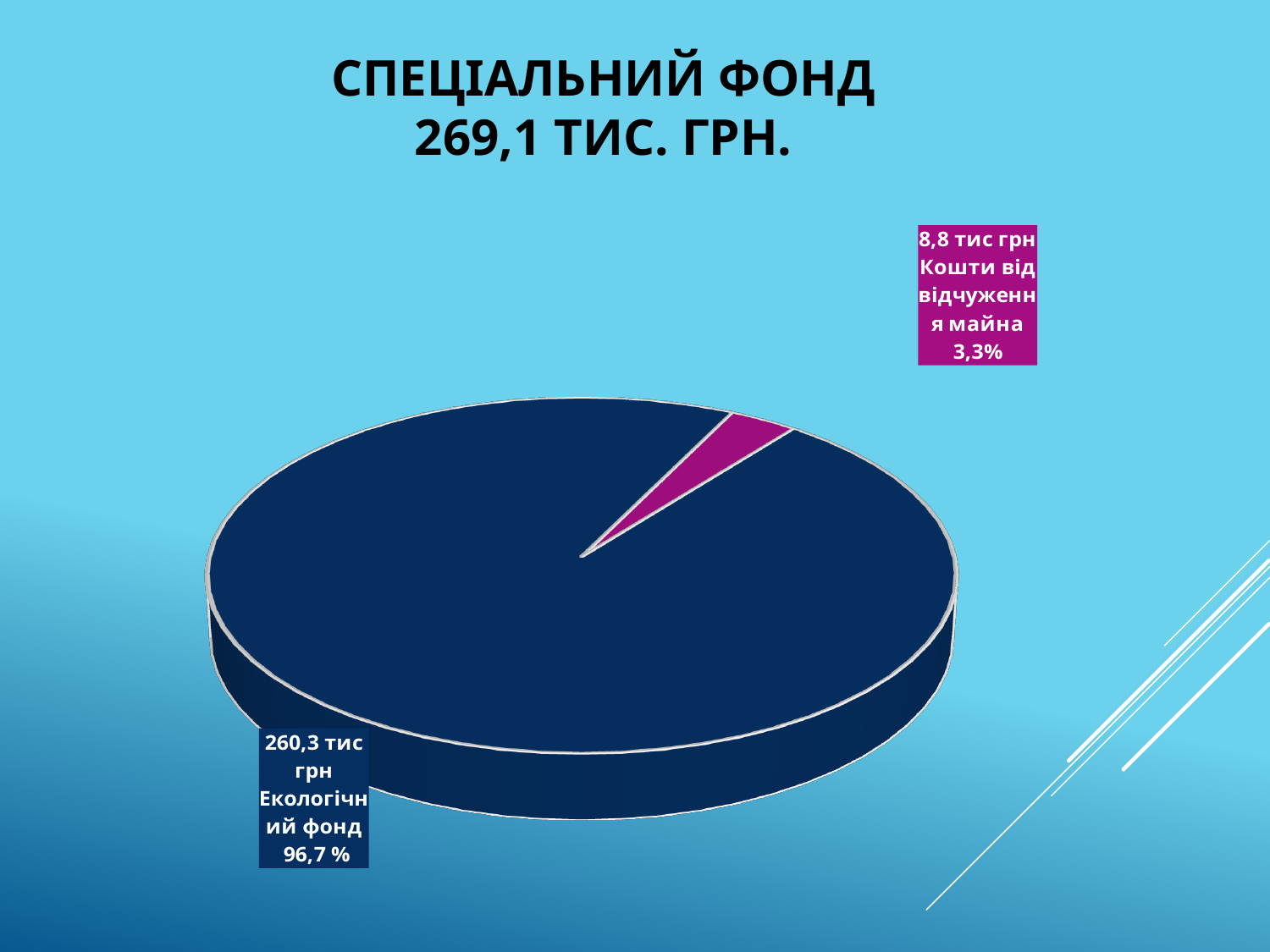
Which is larger, Екологічний фонд or Кошти від відчуження майна? Екологічний фонд What kind of chart is shown on the slide? pie chart What is the title of the chart? СПЕЦІАЛЬНИЙ ФОНД 269,1 ТИС. ГРН. What colour is the slice for Кошти від відчуження майна? magenta Which slice is the smallest? Кошти від відчуження майна What is the value for Екологічний фонд? 260,3 тис грн How many slices does the pie chart have? 2 Which slice is the largest? Екологічний фонд What share of the pie does Кошти від відчуження майна represent? 3,3% What is the value for Кошти від відчуження майна? 8,8 тис грн What share of the pie does Екологічний фонд represent? 96,7 % What is the difference in тис грн between Екологічний фонд and Кошти від відчуження майна? 251,5 тис грн